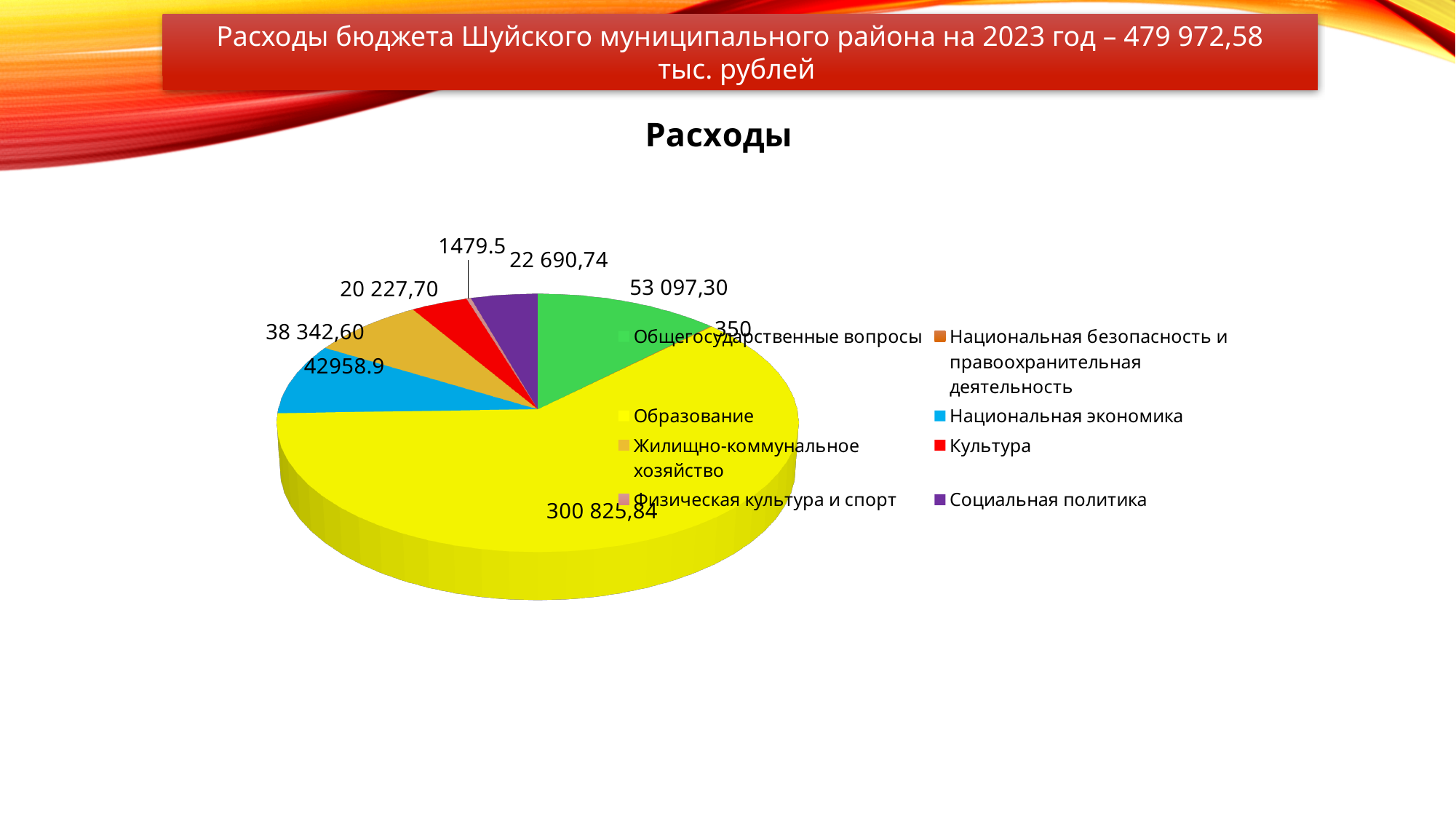
Which category has the smallest value in the Расходы pie chart? Национальная безопасность и правоохранительная деятельность What is the value for Национальная экономика in the Расходы pie chart? 42958.9 What colour is the Образование slice in the Расходы pie chart? Yellow Which is larger in the Расходы pie chart: Жилищно-коммунальное хозяйство or Национальная экономика? Национальная экономика What is the value for Культура in the Расходы pie chart? 20 227,70 What is the value for Социальная политика in the Расходы pie chart? 22 690,74 How many categories are shown in the Расходы pie chart? 8 What type of chart is shown on the slide? Pie chart What is the value for Образование in the Расходы pie chart? 300 825,84 What is the difference between Общегосударственные вопросы and Социальная политика in the Расходы pie chart? 30 406,56 What is the value for Общегосударственные вопросы in the Расходы pie chart? 53 097,30 Which category has the largest slice in the Расходы pie chart? Образование